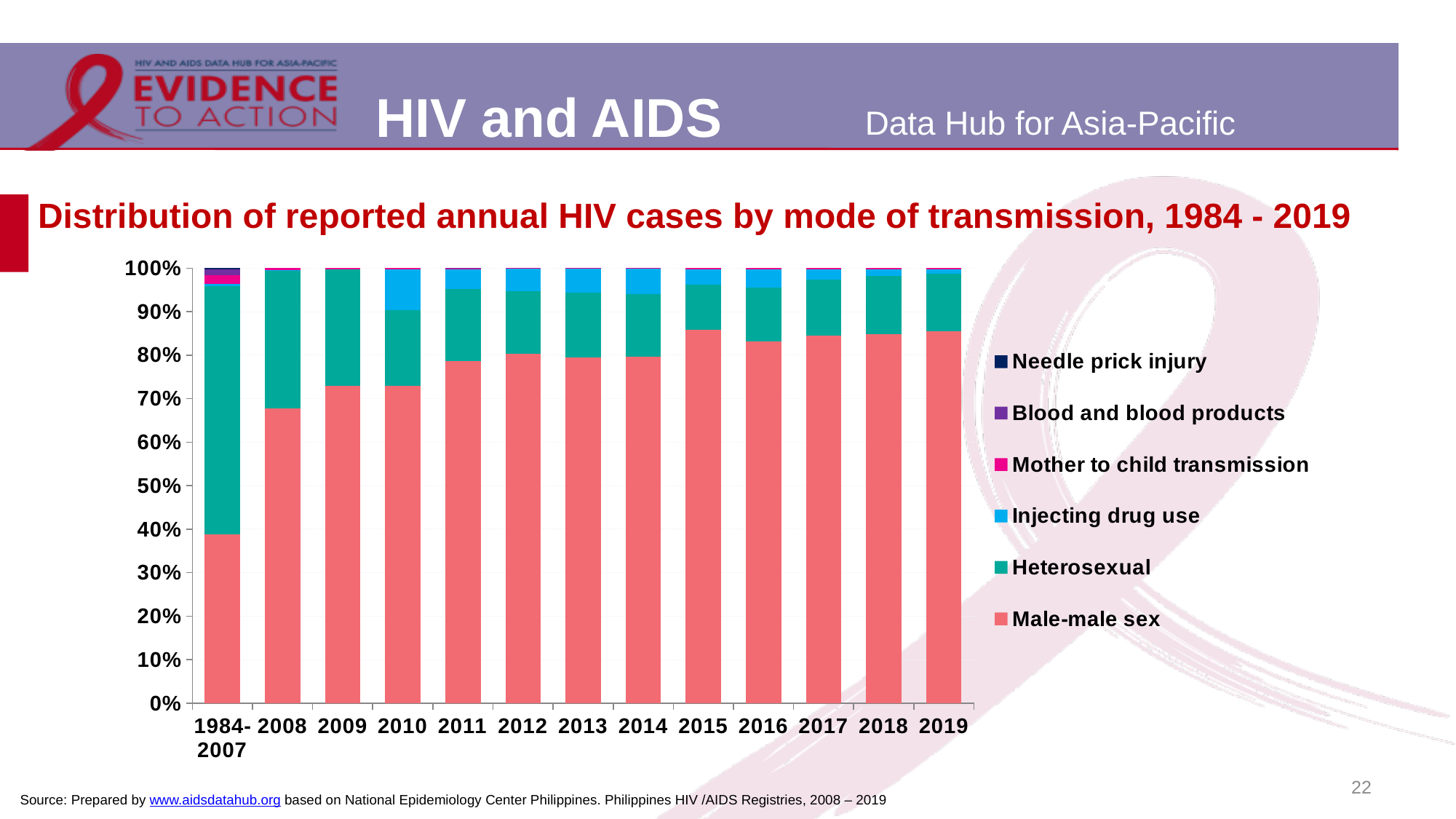
Is the Male-male sex share for 2019 greater or less than 80%? greater What kind of chart is shown on the slide? Stacked bar chart Is the Male-male sex share for 2008 greater or less than 60%? greater Does the Male-male sex share generally rise or fall from 1984-2007 to 2019? rise How many time periods (bars) are shown on the x axis? 13 What is the title of the chart? Distribution of reported annual HIV cases by mode of transmission, 1984 - 2019 How many modes of transmission does the legend list? 6 Which year has the larger Male-male sex share, 2008 or 2009? 2009 In which period is the Heterosexual share the highest? 1984-2007 In which period is the Male-male sex share the lowest? 1984-2007 In which year is the Injecting drug use share the highest? 2010 Is the Male-male sex share for 1984-2007 greater or less than 50%? less